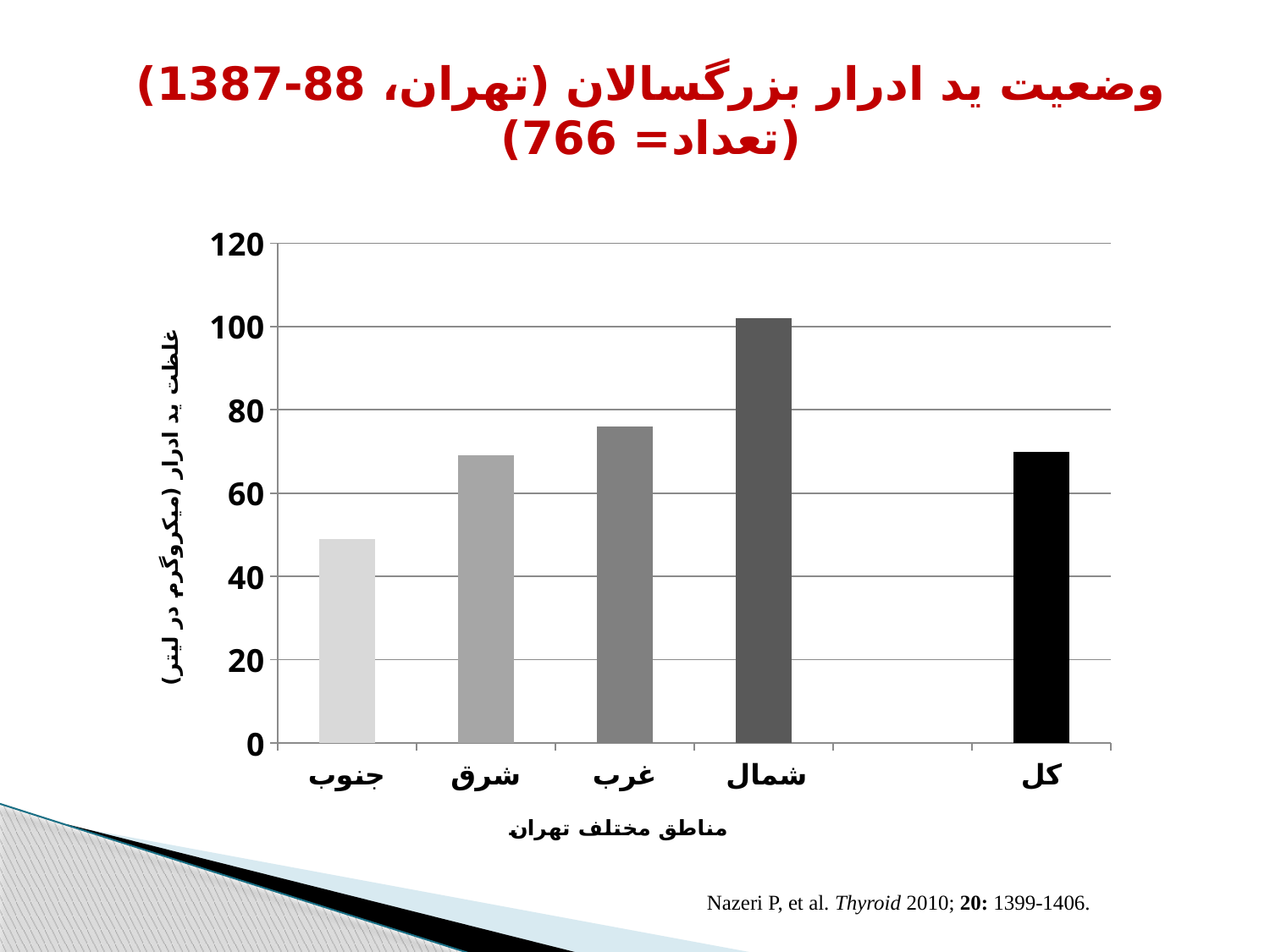
How many categories (bars) are plotted on the chart? 5 Is the value for شمال greater or less than 80? greater Is the value for جنوب greater or less than 60? less Is the value for کل greater or less than 60? greater What is the x-axis title of the chart? مناطق مختلف تهران Which is larger, the value for شمال or the value for غرب? شمال What is the highest value shown on the y-axis of the chart? 120 Which category has the lowest bar? جنوب Which category has the highest bar? شمال Which is larger, the value for جنوب or the value for شرق? شرق What kind of chart is shown on the slide? bar chart